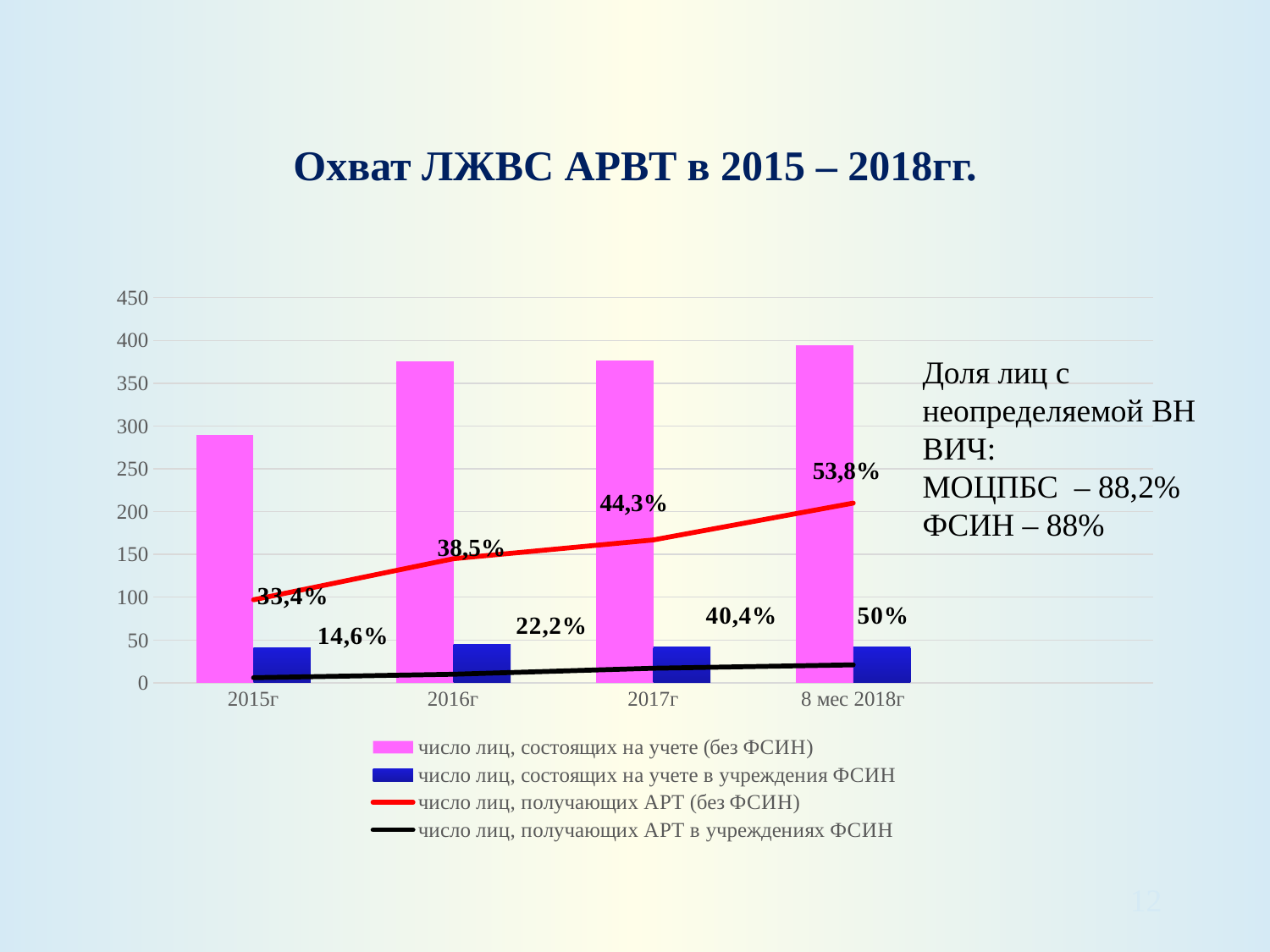
How many time periods are shown on the x axis? 4 What is the data label shown for the red line at 8 мес 2018г? 53,8% What is the data label shown for the black line (число лиц, получающих АРТ в учреждениях ФСИН) at 2016г? 22,2% Is the pink bar for 2015г greater or less than 300? less Is the blue bar for 2017г greater or less than 50? less What is the data label shown for the red line (число лиц, получающих АРТ (без ФСИН)) at 2015г? 33,4% How many series does the legend list? 4 Does the red line (число лиц, получающих АРТ (без ФСИН)) rise or fall from 2015г to 8 мес 2018г? rise Is the pink bar for 2016г greater or less than 350? greater In which year is the pink bar (число лиц, состоящих на учете (без ФСИН)) the highest? 8 мес 2018г What is the data label shown for the black line at 2017г? 40,4% In which year is the pink bar (число лиц, состоящих на учете (без ФСИН)) the lowest? 2015г